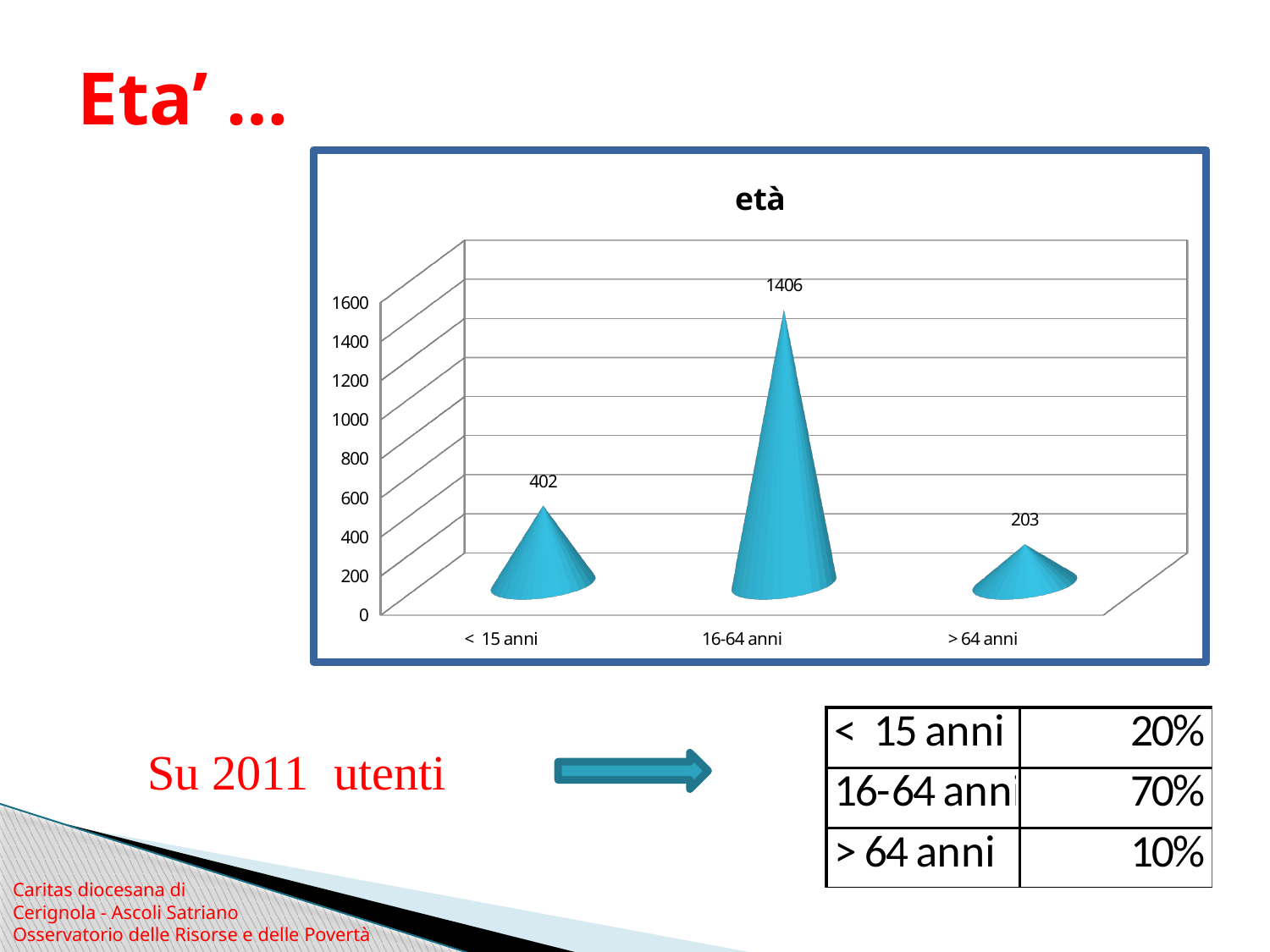
What is the value for the '< 15 anni' category? 402 What is the difference between the values for '16-64 anni' and '< 15 anni'? 1004 Is the value for '16-64 anni' greater or less than 1000? greater How many age categories are shown in the chart? 3 What is the difference between the values for '< 15 anni' and '> 64 anni'? 199 What is the title of the chart? età What is the value for the '> 64 anni' category? 203 Which is larger, the value for '< 15 anni' or the value for '> 64 anni'? < 15 anni What kind of chart is shown on the slide? bar chart What is the value for the '16-64 anni' category? 1406 Which age category has the highest value? 16-64 anni Which age category has the lowest value? > 64 anni